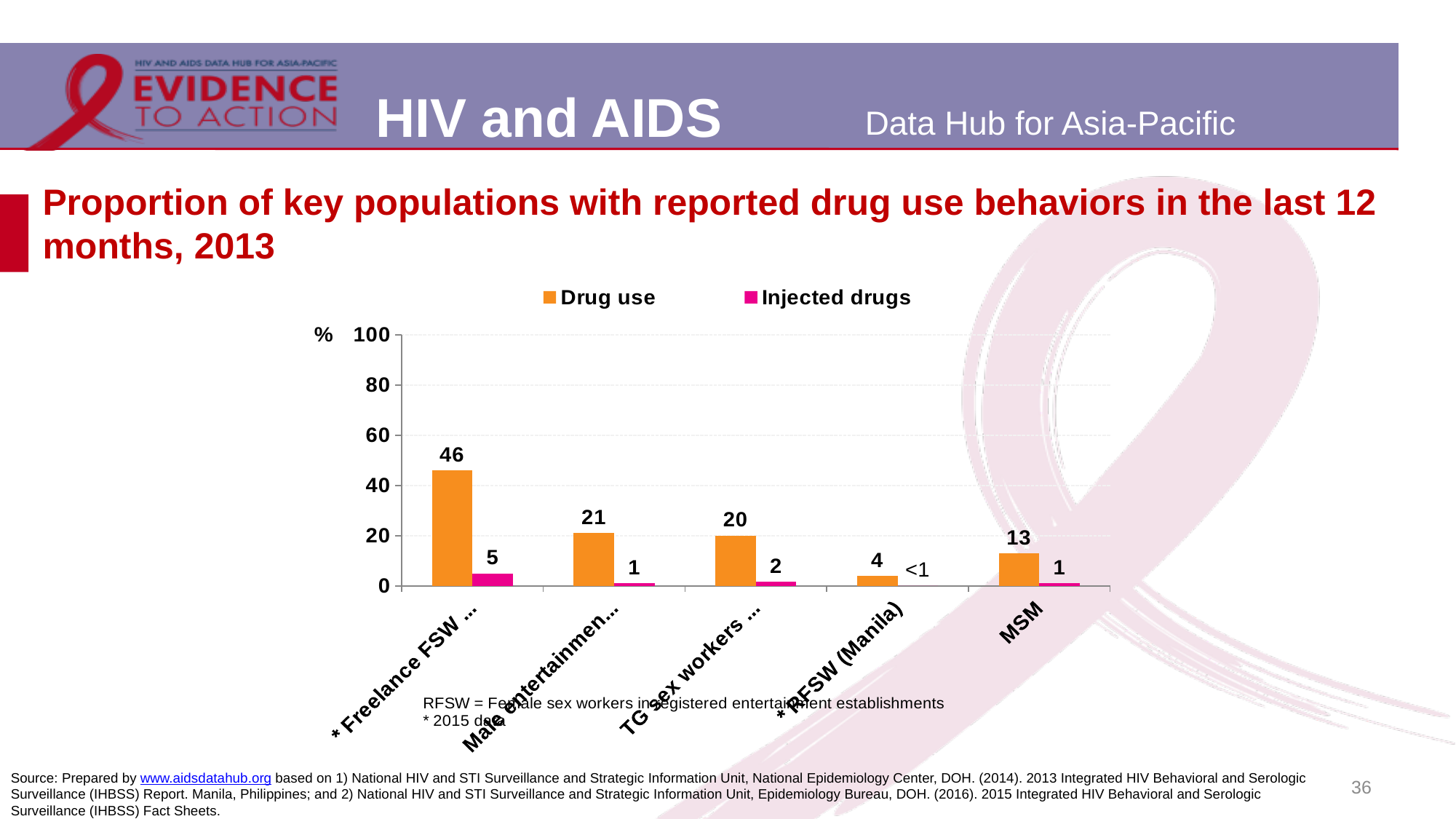
What is the Injected drugs value for MSM? 1 Which key population has the highest Drug use value? Freelance FSW How many key population categories are shown on the x axis? 5 How many series does the legend list? 2 What is the difference between the Drug use values for MSM and RFSW (Manila)? 9 What kind of chart is shown on the slide? Bar chart What is the Drug use value for RFSW (Manila)? 4 For Freelance FSW, what is the difference between the Drug use and Injected drugs values? 41 What is the Drug use value for MSM? 13 What is the Injected drugs value for RFSW (Manila)? <1 Which key population has the lowest Drug use value? RFSW (Manila) Which has a higher Drug use value, MSM or TG sex workers? TG sex workers